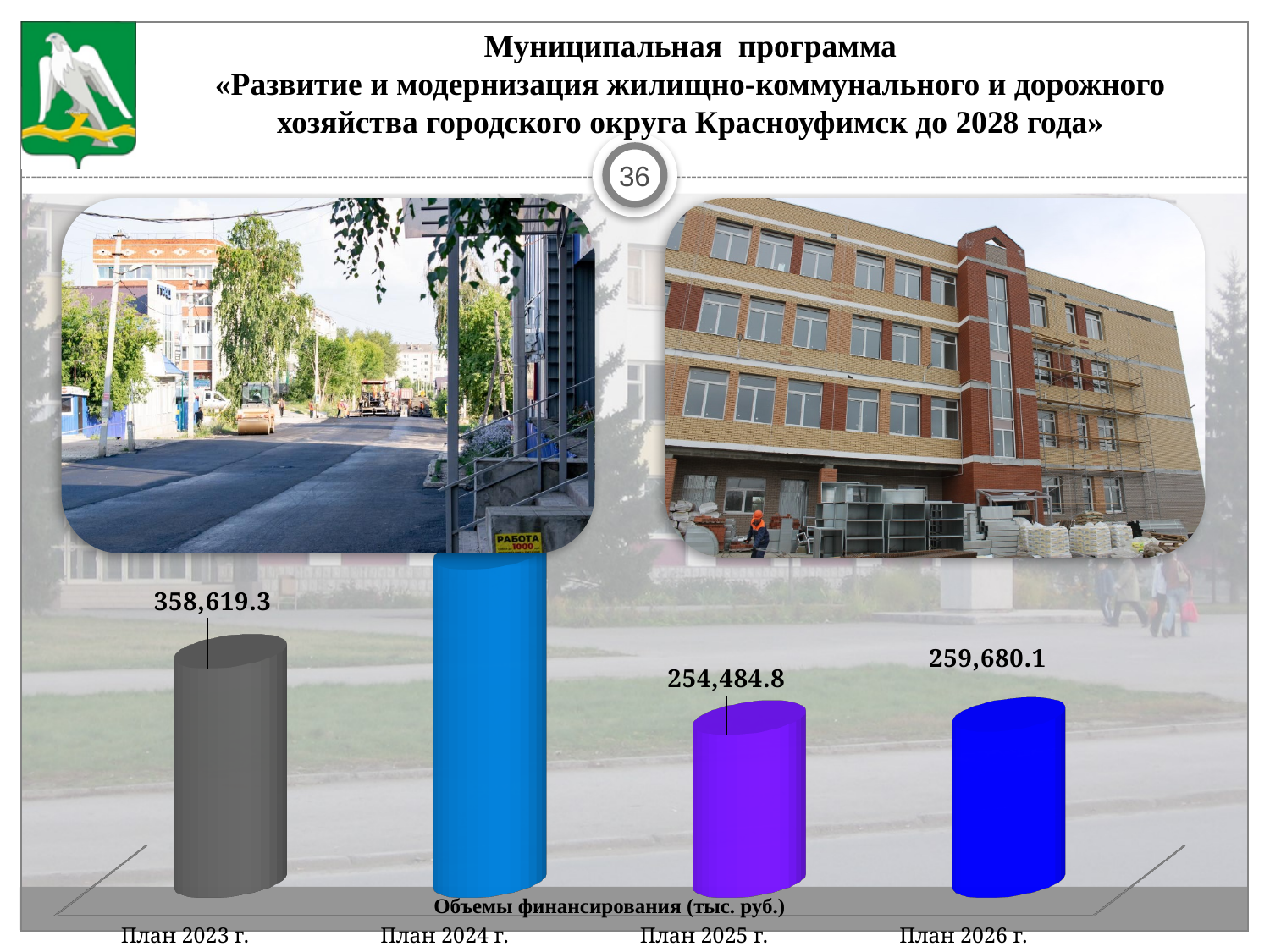
What kind of chart is shown on the slide? Bar chart How many categories (years) are shown in the chart? 4 Which year has the lowest value in the chart? План 2025 г. What is the planned financing value for План 2026 г.? 259,680.1 What is the planned financing value for План 2025 г.? 254,484.8 Which year has the highest bar in the chart? План 2024 г. Which is larger, the value for План 2023 г. or the value for План 2026 г.? План 2023 г. What is the difference between the values for План 2023 г. and План 2025 г.? 104,134.5 What is the axis title shown under the bars? Объемы финансирования (тыс. руб.) What is the planned financing value for План 2023 г.? 358,619.3 What is the difference between the values for План 2026 г. and План 2025 г.? 5,195.3 What colour is the bar for План 2023 г.? Grey